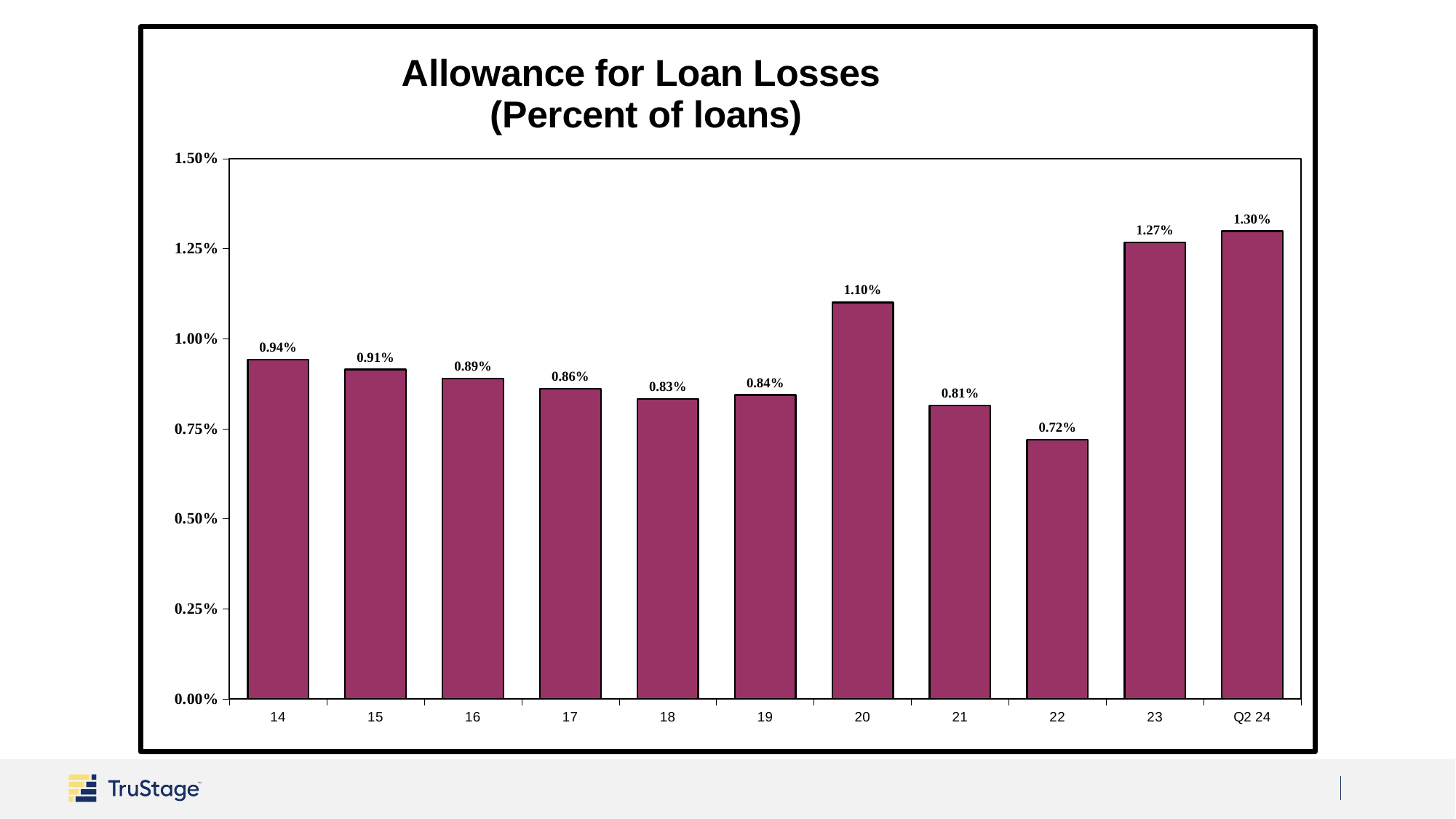
What is the allowance for loan losses as a percent of loans in 20? 1.10% What is the title of the chart? Allowance for Loan Losses (Percent of loans) What is the value shown for 18? 0.83% Do the values rise or fall from 14 to 18? fall Is the value for 21 greater or less than 1.00%? less Which category has the highest allowance for loan losses? Q2 24 What kind of chart is shown on the slide? bar chart How many categories are shown on the x axis? 11 Which is larger, the value for 14 or the value for 15? 14 What is the difference between the values for 23 and 22? 0.55% What is the value shown for Q2 24? 1.30% Which category has the lowest allowance for loan losses? 22